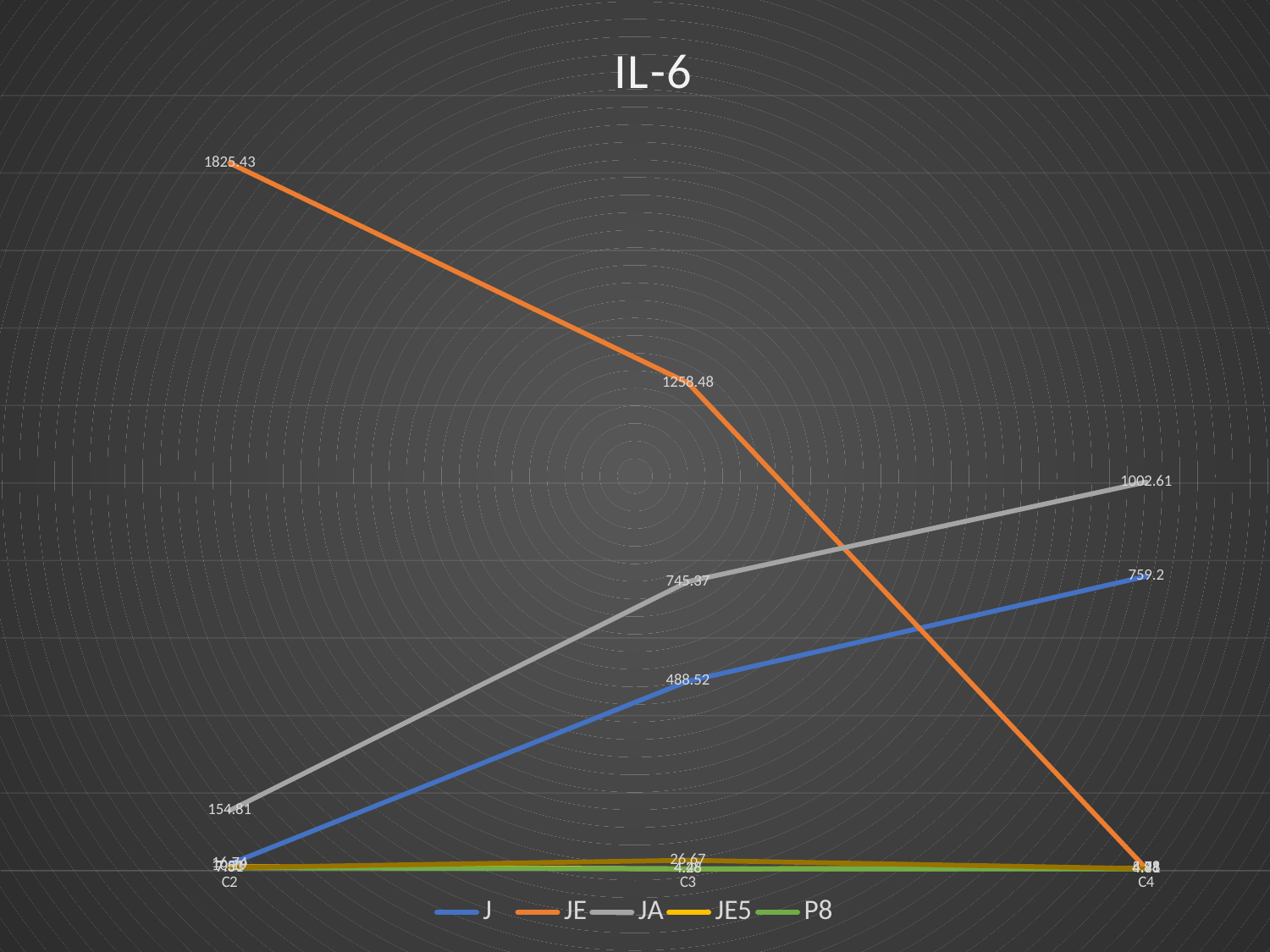
How many series does the legend list? 5 What is the value for JE at C2? 1825.43 What is the title of the chart? IL-6 What kind of chart is shown on the slide? line chart Which series has the highest value at C2? JE How many categories are shown on the x axis? 3 What is the value for JE at C3? 1258.48 What is the value for JA at C4? 1002.61 Does the JE series rise or fall from C2 to C4? fall What is the difference between the JA value at C4 and the J value at C4? 243.41 What is the value for JA at C2? 154.81 What is the value for J at C3? 488.52